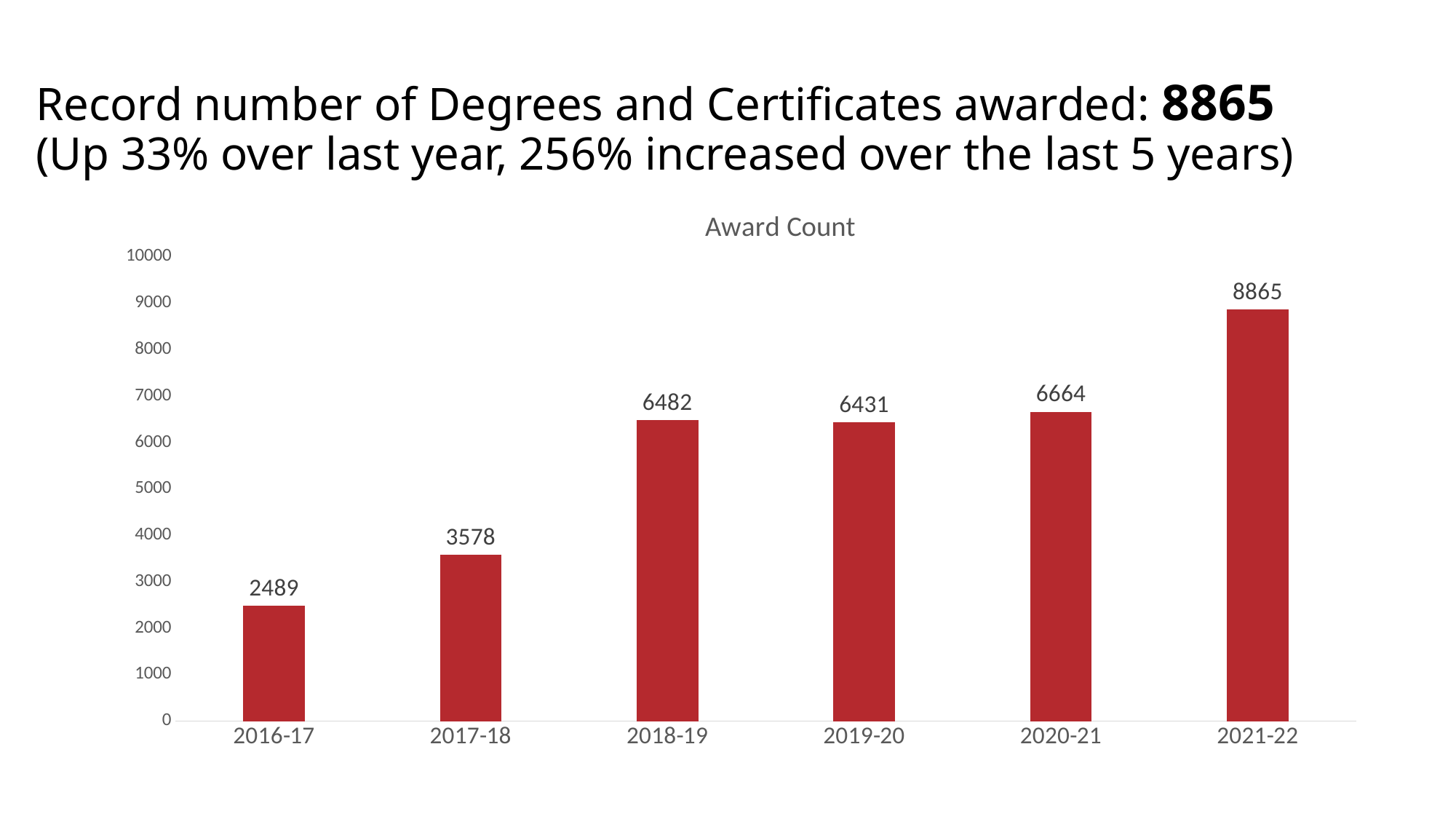
Which year has the lowest award count? 2016-17 What is the title of the chart? Award Count What is the difference in award count between 2017-18 and 2016-17? 1089 How many years are shown on the x axis of the chart? 6 What is the award count for 2020-21? 6664 Which year has the highest award count? 2021-22 What is the difference in award count between 2021-22 and 2020-21? 2201 What is the award count for 2019-20? 6431 Is the award count for 2017-18 greater or less than 4000? less What kind of chart is shown on the slide? bar chart Which is larger, the award count for 2018-19 or for 2019-20? 2018-19 What is the award count for 2016-17? 2489